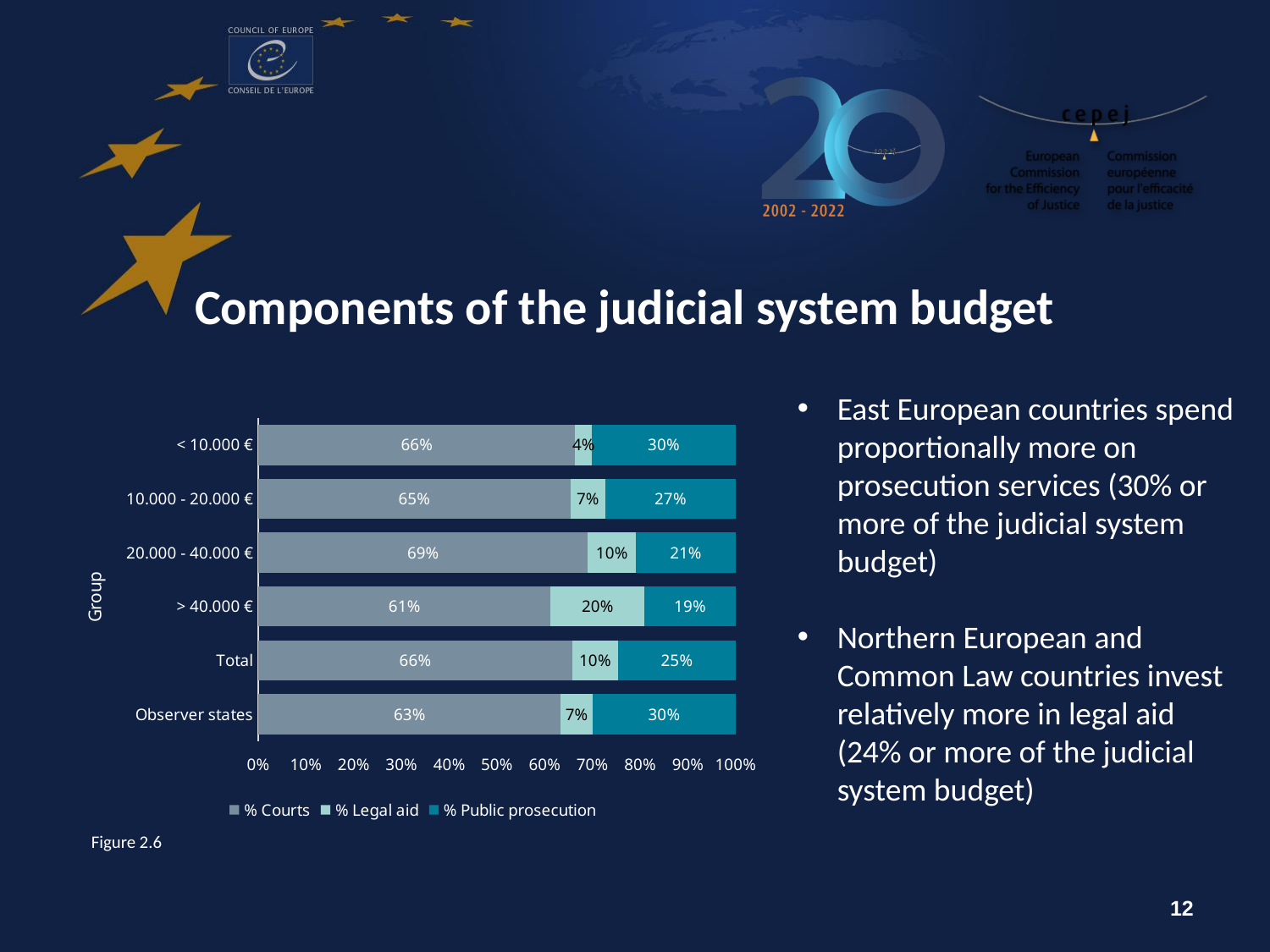
Which group has the highest % Courts value? 20.000 - 40.000 € Which group has the highest % Legal aid value? > 40.000 € Which group has the lowest % Courts value? > 40.000 € What kind of chart is shown on the slide? Stacked bar chart What percentage of the judicial system budget goes to courts for the < 10.000 € group? 66% How many groups are shown on the chart? 6 How many series does the legend list? 3 What is the difference between the % Public prosecution values for the < 10.000 € group and the > 40.000 € group? 11% What is the % Legal aid value for the > 40.000 € group? 20% Which is larger: the % Legal aid value for the 10.000 - 20.000 € group or for the 20.000 - 40.000 € group? 20.000 - 40.000 € What is the label of the vertical axis of the chart? Group What is the % Public prosecution value for Observer states? 30%